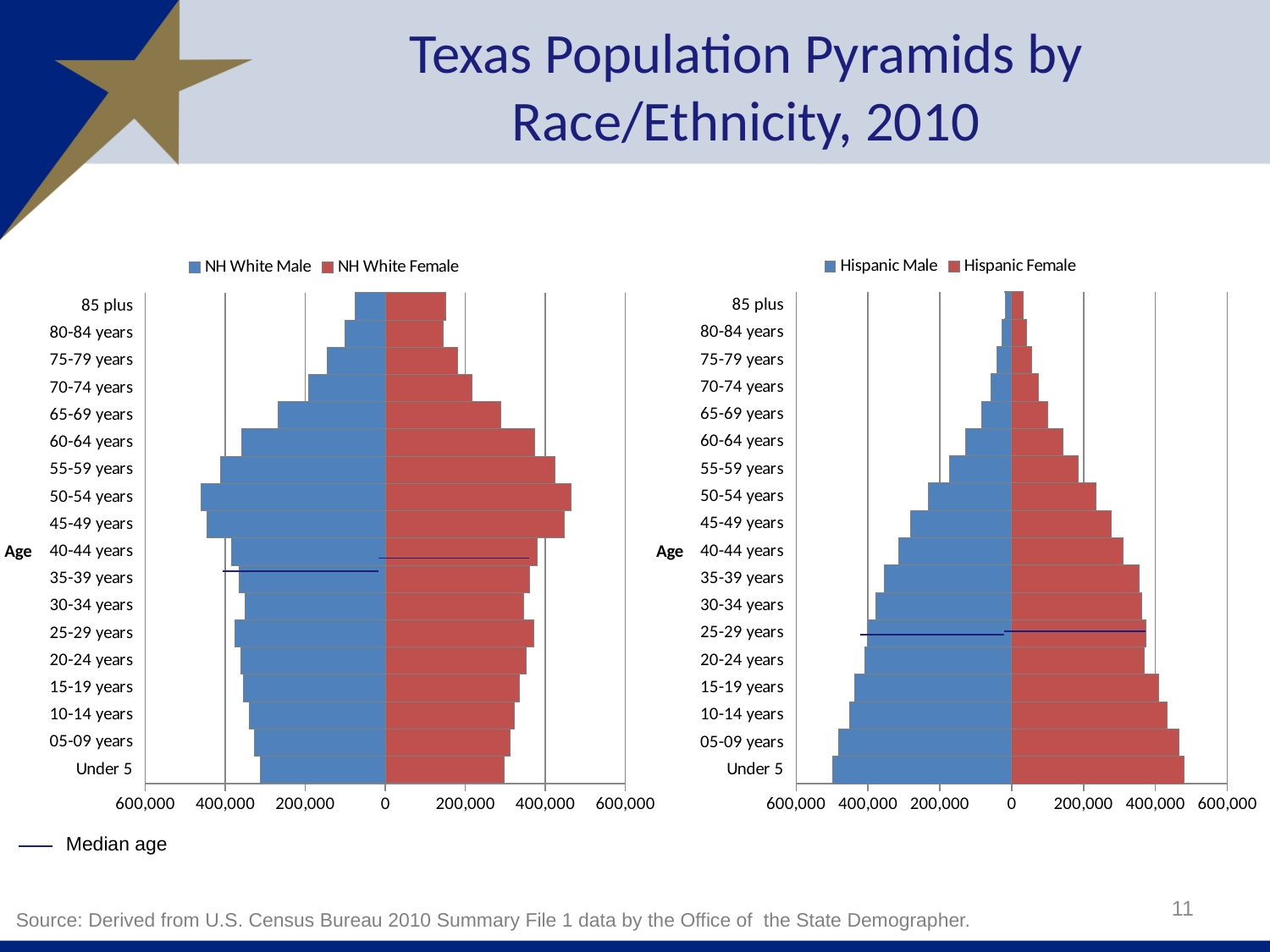
In the Hispanic chart on the right, which age group has the smallest Hispanic Female bar? 85 plus How many series does the legend of the Hispanic chart on the right list? 2 In the NH White chart on the left, is the NH White Female value for 85 plus greater or less than 200,000? less What kind of chart is the NH White population pyramid on the left? bar chart In the NH White chart on the left, which age group has the largest NH White Female bar? 50-54 years In the Hispanic chart on the right, do the bars get larger or smaller as age increases from Under 5 to 85 plus? smaller In the Hispanic chart on the right, is the Hispanic Female value for Under 5 greater or less than 400,000? greater In the NH White chart on the left, is the NH White Male value for 50-54 years greater or less than 400,000? greater Which is larger: the Hispanic Male bar for Under 5 in the right chart or the NH White Male bar for Under 5 in the left chart? Hispanic Male What are the two legend entries of the chart on the left? NH White Male, NH White Female How many age categories are shown on the y axis of the NH White chart on the left? 18 In the Hispanic chart on the right, which age group has the largest Hispanic Male bar? Under 5